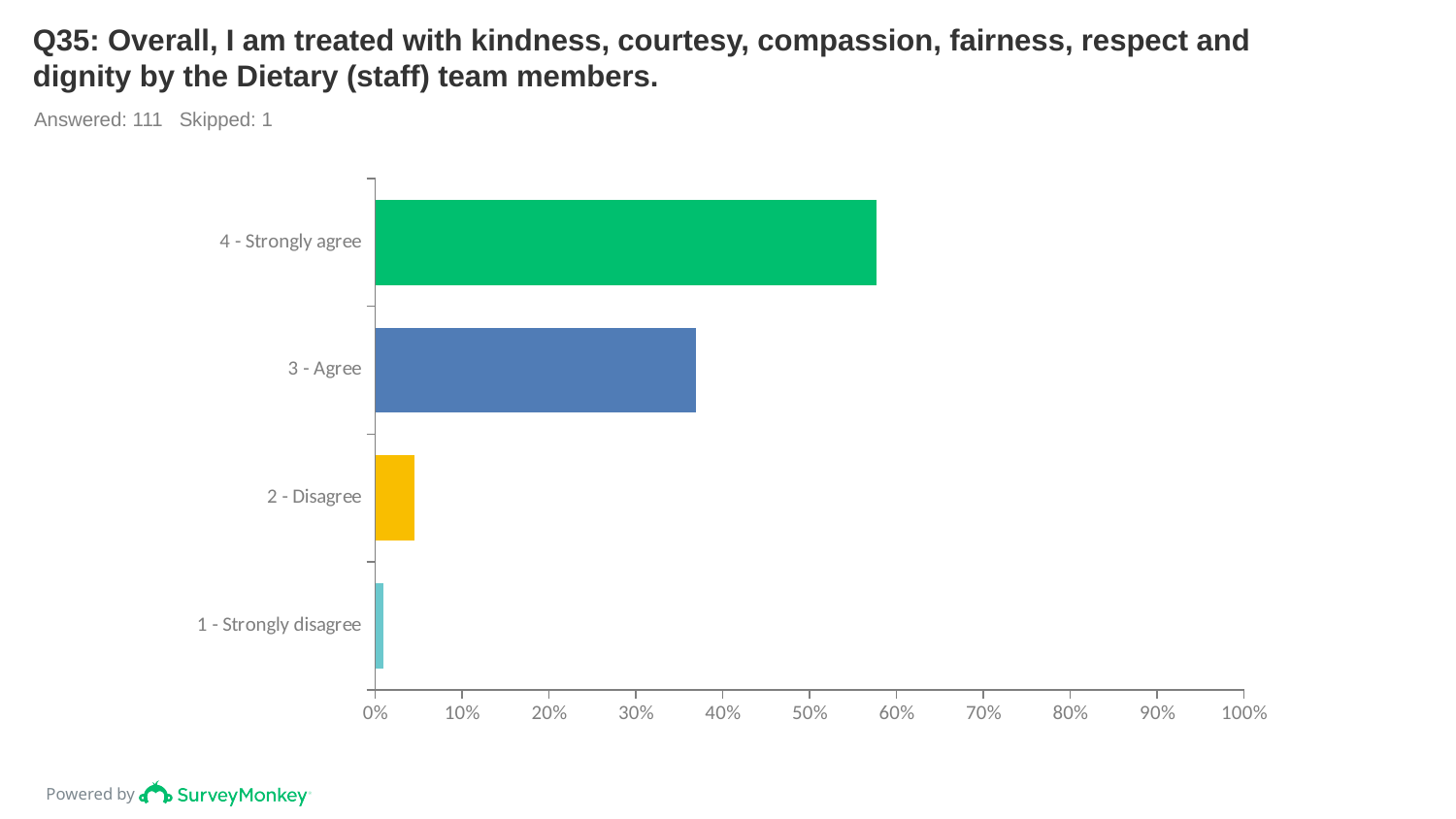
Is the value for 3 - Agree greater or less than 40%? less How many respondents answered this question according to the slide? 111 Which category has the lowest value? 1 - Strongly disagree Is the value for 4 - Strongly agree greater or less than 50%? greater Is the value for 2 - Disagree greater or less than 10%? less Which is larger, the value for 3 - Agree or the value for 2 - Disagree? 3 - Agree What is the maximum value shown on the horizontal axis? 100% How many categories are plotted in the chart? 4 Which category has the highest value? 4 - Strongly agree What kind of chart is shown on the slide? bar chart